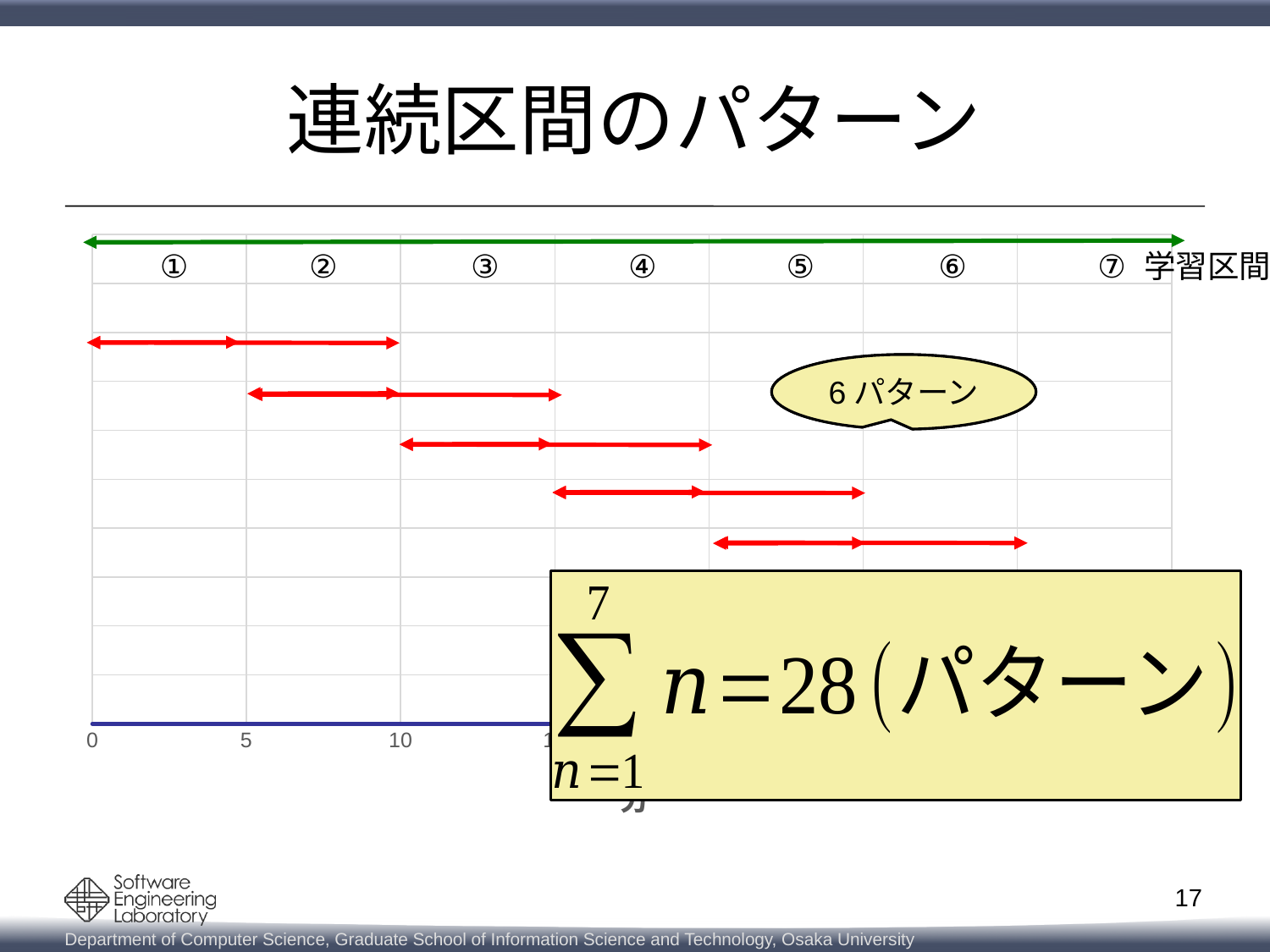
According to the formula box, what is the total number of patterns (the value of the sum from n=1 to 7 of n)? 28 What label appears at the right end of the green arrow above the chart? 学習区間 What is the upper limit of the summation index n in the formula box? 7 What colour are the double-headed arrows that mark the consecutive-interval patterns? red What is the leftmost tick value shown on the x axis? 0 What does the callout bubble inside the chart say? 6 パターン At which x-axis value does the first (topmost) red arrow start? 0 How many numbered intervals does each red double-headed arrow span? 2 How many numbered intervals (①–⑦) are labelled along the top of the chart? 7 At which x-axis value does the first (topmost) red arrow end? 10